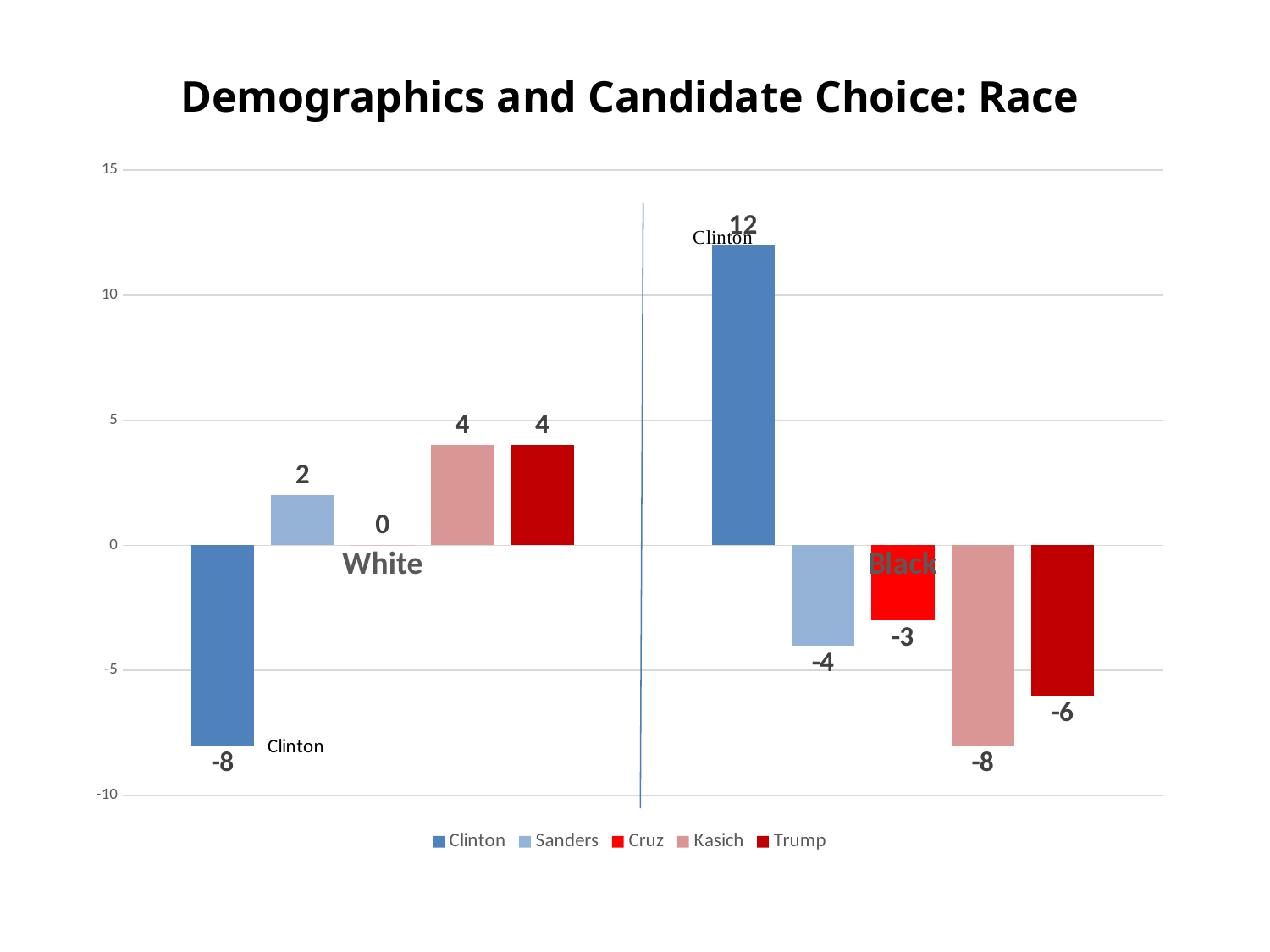
What is the value for Clinton in the White category? -8 What is the title of the chart? Demographics and Candidate Choice: Race Which candidate has the highest value in the Black category? Clinton What is the value for Kasich in the Black category? -8 Which candidate has the lowest value in the White category? Clinton What is the difference between Clinton's value in the Black category and Clinton's value in the White category? 20 Which is larger: Trump's value in the Black category or Cruz's value in the Black category? Cruz What kind of chart is shown on the slide? Bar chart What is the value for Cruz in the White category? 0 What is the value for Clinton in the Black category? 12 How many series does the legend list? 5 What is the value for Sanders in the Black category? -4